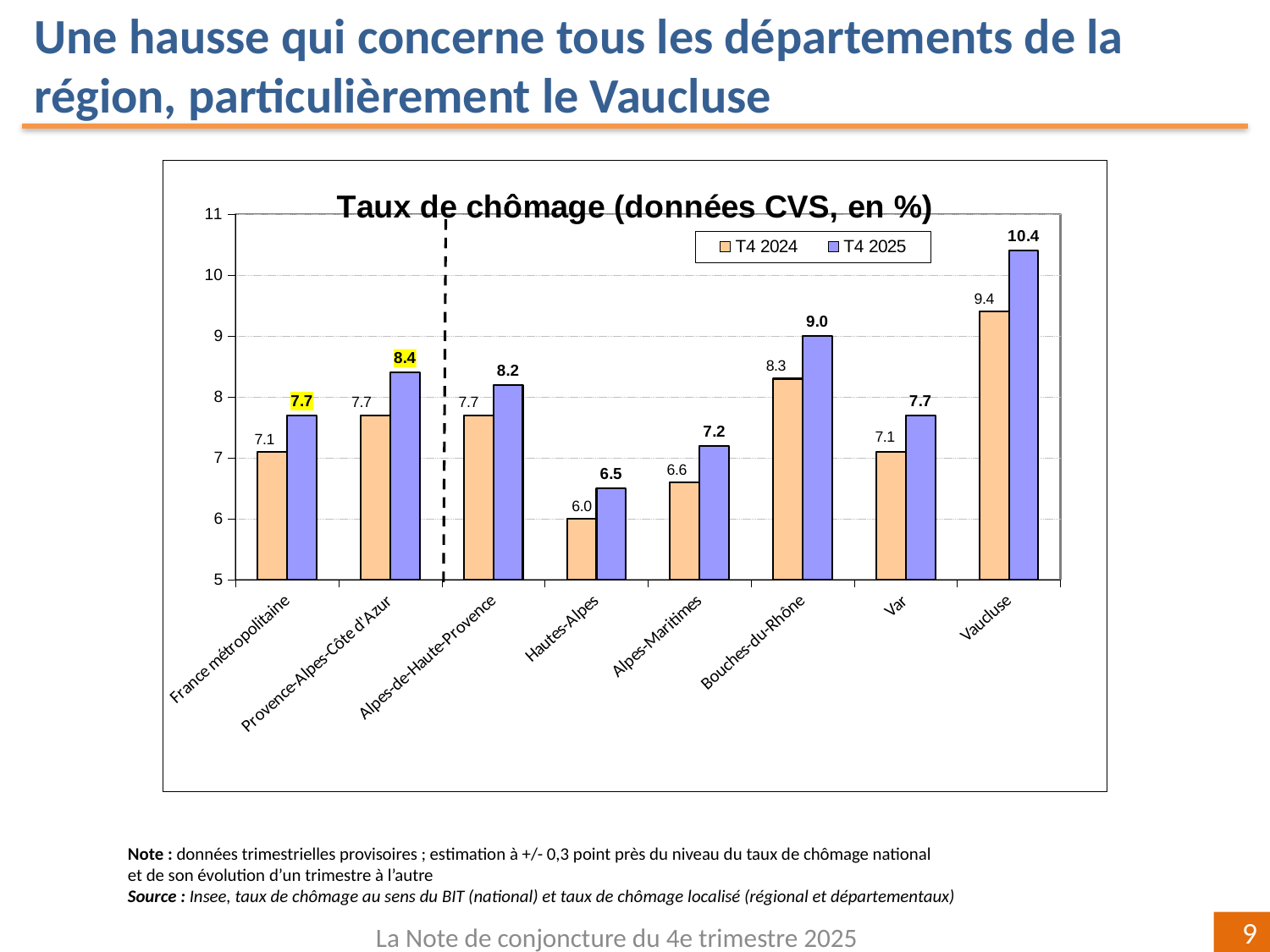
What kind of chart is shown? Bar chart How many categories are shown on the x axis? 8 Which category has the highest T4 2025 value? Vaucluse What is the T4 2024 value for Hautes-Alpes? 6.0 What is the difference between the T4 2025 and T4 2024 values for Vaucluse? 1.0 What is the T4 2025 value for Bouches-du-Rhône? 9.0 Which is larger: the T4 2025 value for Bouches-du-Rhône or the T4 2025 value for Provence-Alpes-Côte d'Azur? Bouches-du-Rhône Which category has the lowest T4 2024 value? Hautes-Alpes What is the T4 2024 value for Alpes-Maritimes? 6.6 How many series does the legend list? 2 What is the title of the chart? Taux de chômage (données CVS, en %) What is the T4 2025 unemployment rate for Vaucluse? 10.4